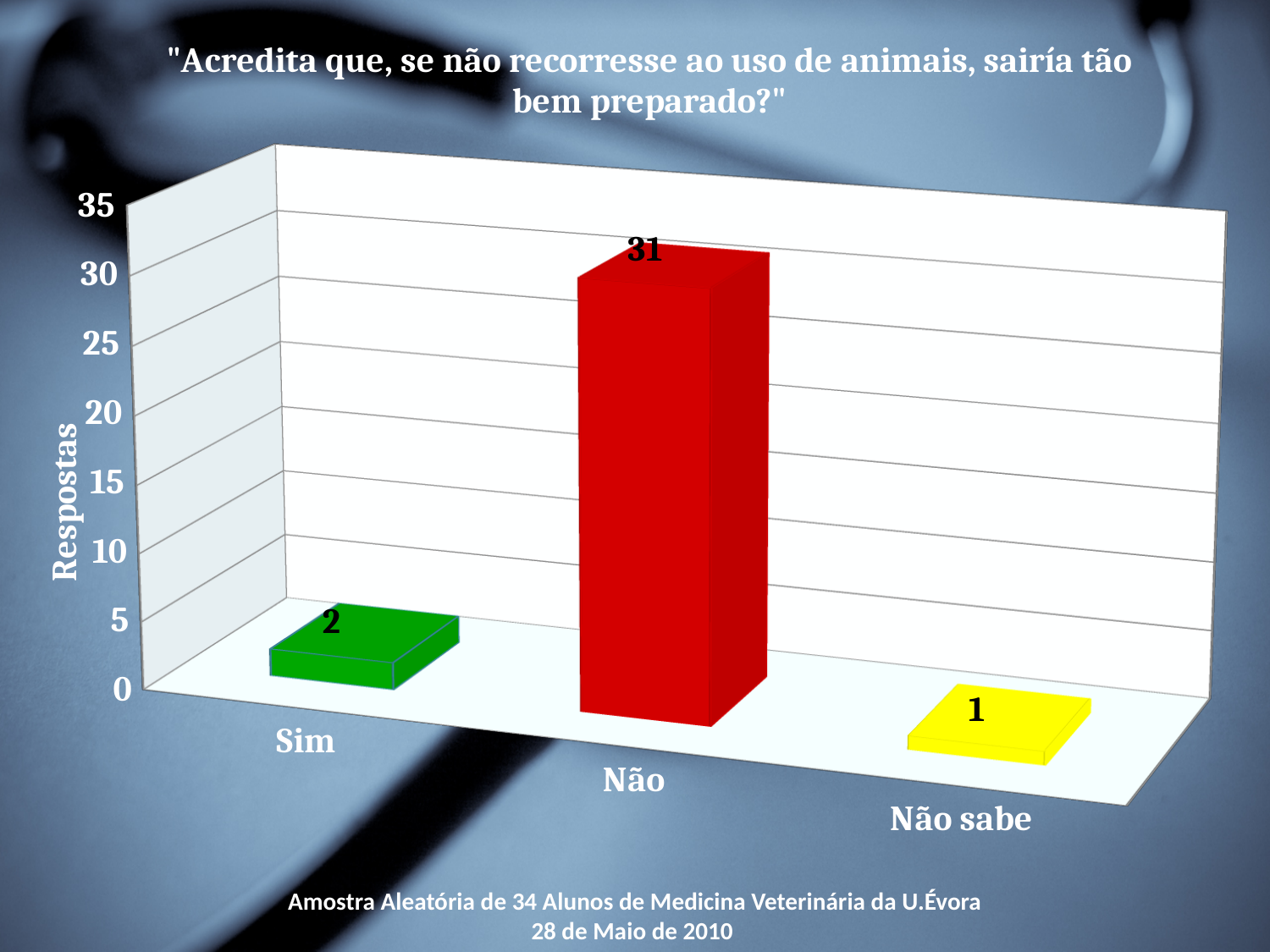
Which category has the highest value? Não What is the label of the vertical axis? Respostas What is the value for "Não"? 31 What is the value for "Sim"? 2 What is the difference between the values for "Não" and "Sim"? 29 What is the value for "Não sabe"? 1 Is the value for "Não" greater or less than 30? greater What kind of chart is shown on the slide? bar chart What colour is the bar for "Não"? red Which is larger, the value for "Sim" or the value for "Não sabe"? Sim Which category has the lowest value? Não sabe How many categories are shown on the x axis? 3